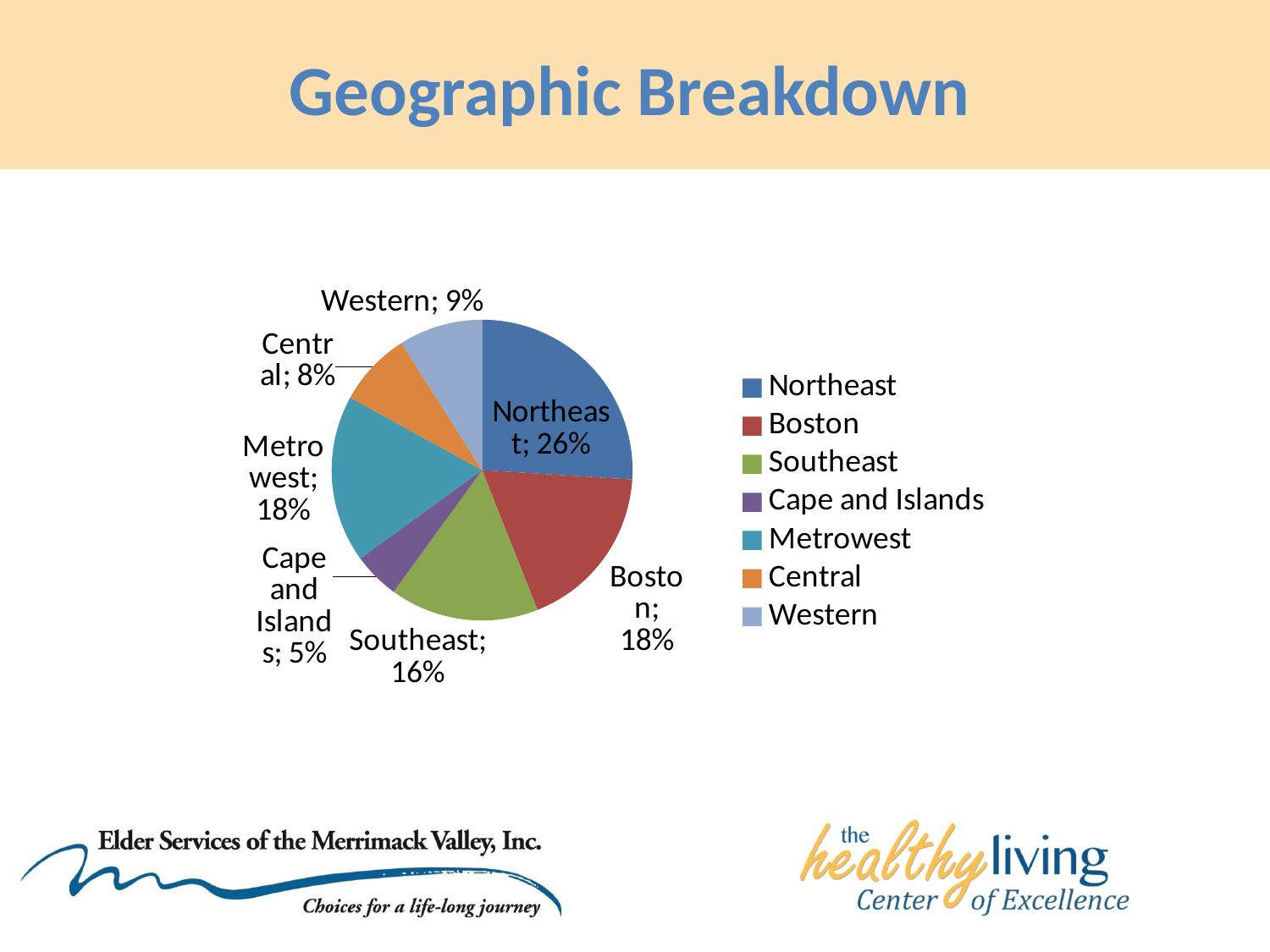
What is the title of the slide containing the chart? Geographic Breakdown What kind of chart is shown on the slide? pie chart What share of the pie does Northeast represent? 26% What percentage is shown for Cape and Islands? 5% What is the difference in percentage points between Northeast and Western? 17 Which is larger, the Central slice or the Western slice? Western What percentage is shown for Southeast? 16% Which region has the smallest slice of the pie? Cape and Islands Which legend entry is shown in orange? Central What percentage is shown for Metrowest? 18% Which region has the largest slice of the pie? Northeast How many regions are shown in the pie chart? 7